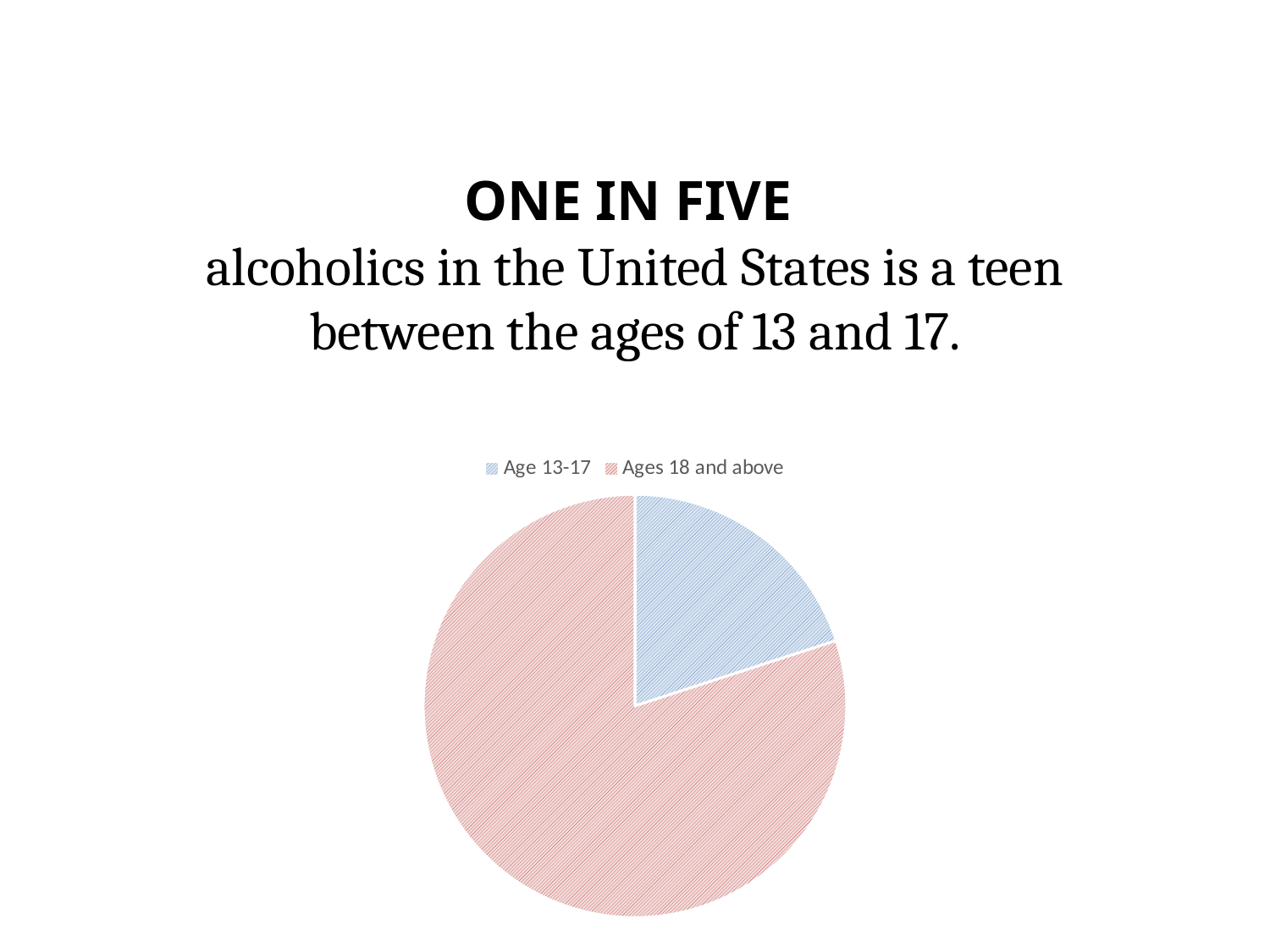
Which slice of the pie chart is the smallest? Age 13-17 Which legend entry is shown in red in the pie chart? Ages 18 and above Which slice is larger in the pie chart, Age 13-17 or Ages 18 and above? Ages 18 and above What kind of chart is shown on the slide? pie chart Which slice of the pie chart is the largest? Ages 18 and above Which legend entry is shown in blue in the pie chart? Age 13-17 How many slices does the pie chart have? 2 How many entries does the legend of the pie chart list? 2